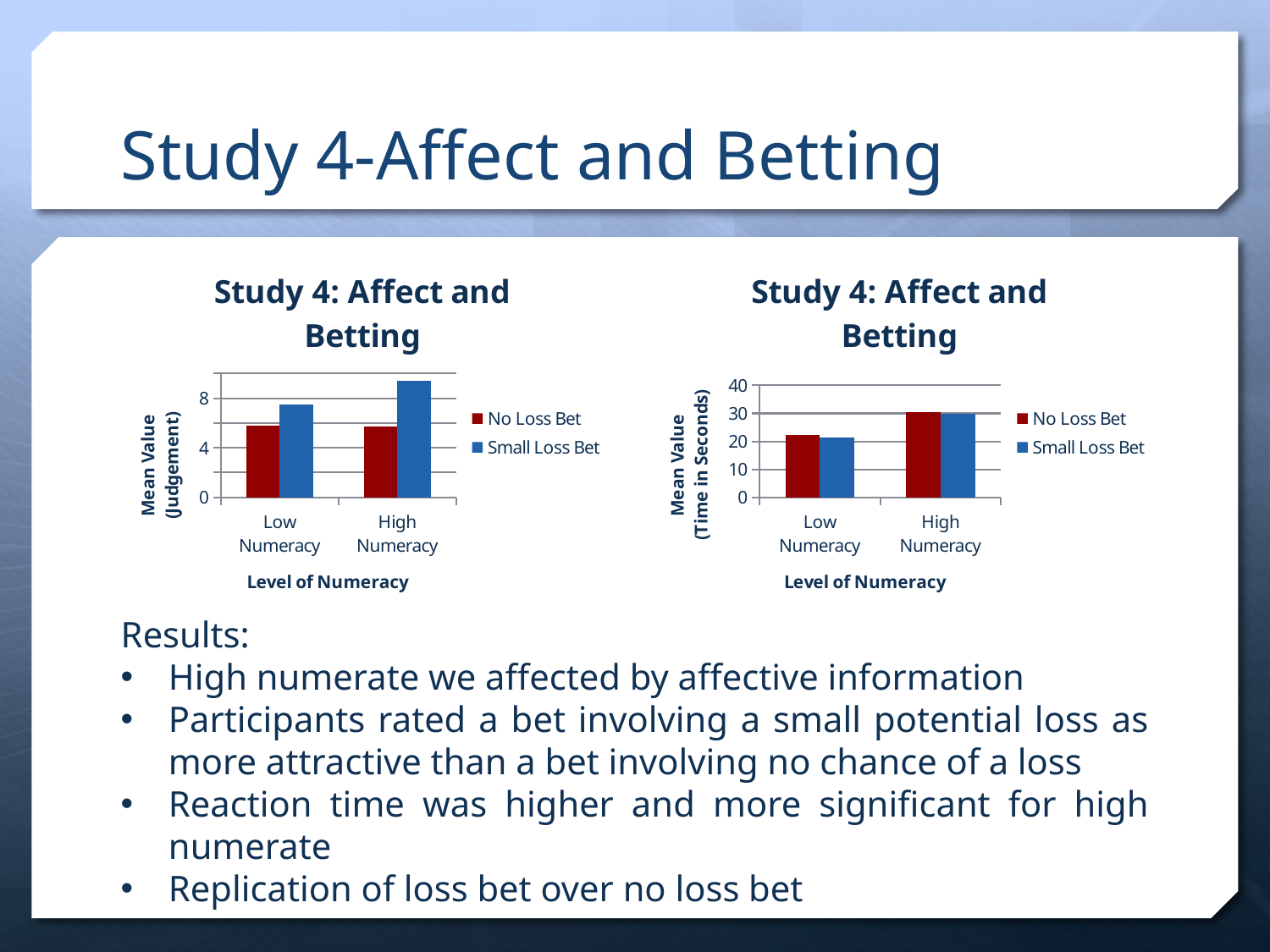
In the left chart (Mean Value Judgement), for Low Numeracy, which is larger: No Loss Bet or Small Loss Bet? Small Loss Bet What is the x-axis title of the right chart (Mean Value Time in Seconds)? Level of Numeracy In the left chart (Mean Value Judgement), which bar is the highest? Small Loss Bet for High Numeracy In the left chart (Mean Value Judgement), is the Small Loss Bet value for High Numeracy greater or less than 8? greater How many series does the legend of the right chart (Mean Value Time in Seconds) list? 2 In the left chart (Mean Value Judgement), is the No Loss Bet value for Low Numeracy greater or less than 8? less In the right chart (Mean Value Time in Seconds), which category has the larger No Loss Bet value: Low Numeracy or High Numeracy? High Numeracy In the right chart (Mean Value Time in Seconds), is the No Loss Bet value for High Numeracy greater or less than 20? greater How many categories are shown on the x axis of the left chart (Mean Value Judgement)? 2 In the right chart (Mean Value Time in Seconds), does the Small Loss Bet value rise or fall from Low Numeracy to High Numeracy? rise What kind of chart is the left chart (Mean Value Judgement)? bar chart